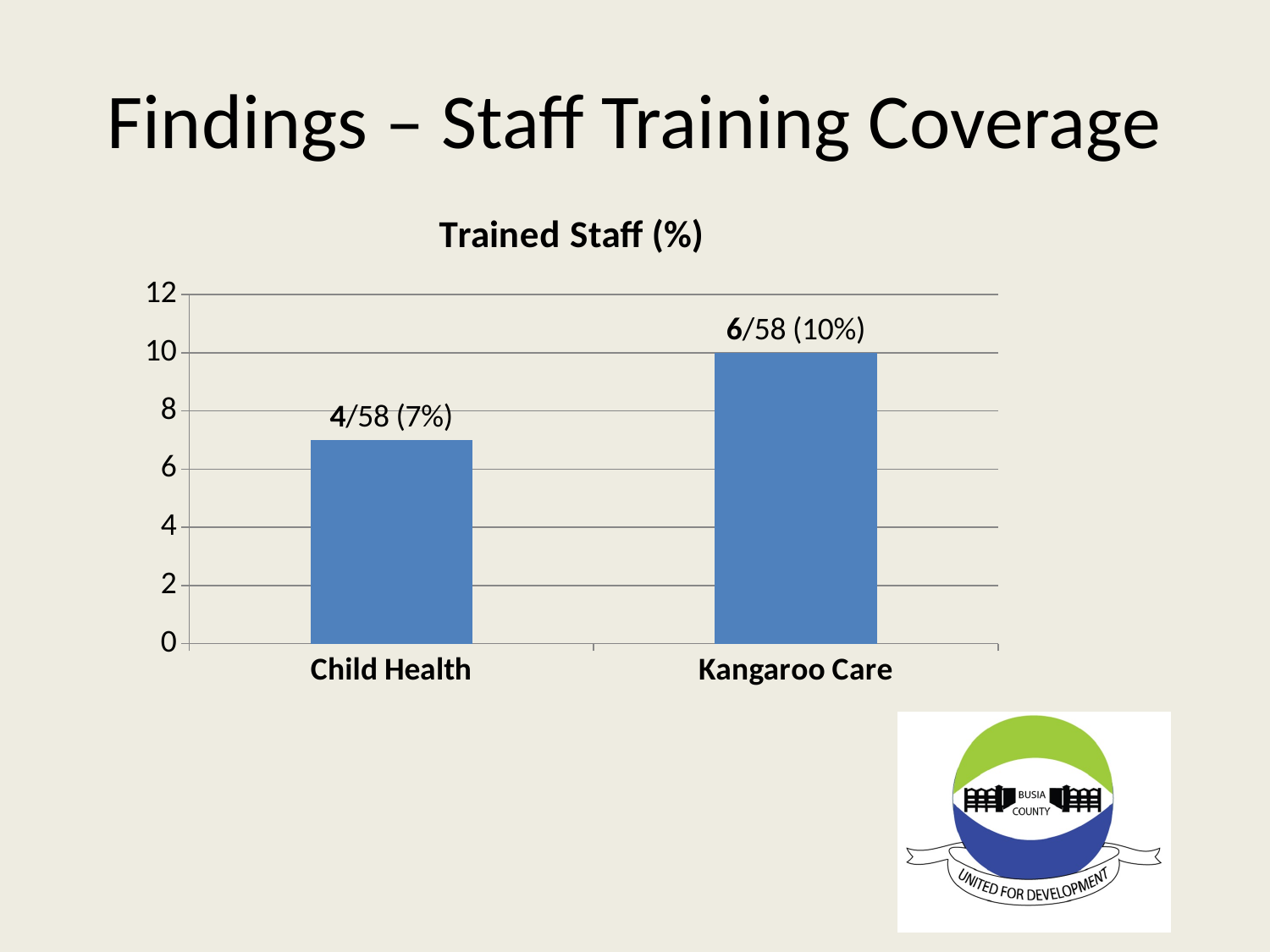
What is the difference in percentage points between Kangaroo Care and Child Health trained staff? 3 Which category has the lowest percentage of trained staff? Child Health Which category has the highest percentage of trained staff? Kangaroo Care What is the data label shown above the Kangaroo Care bar? 6/58 (10%) What is the data label shown above the Child Health bar? 4/58 (7%) Is the value for Child Health greater or less than 8? less What kind of chart is shown on the slide? bar chart Which is larger, the trained staff percentage for Child Health or for Kangaroo Care? Kangaroo Care What percentage of staff are trained in Child Health? 7% How many categories are shown on the x axis? 2 What percentage of staff are trained in Kangaroo Care? 10% What is the title of the chart? Trained Staff (%)